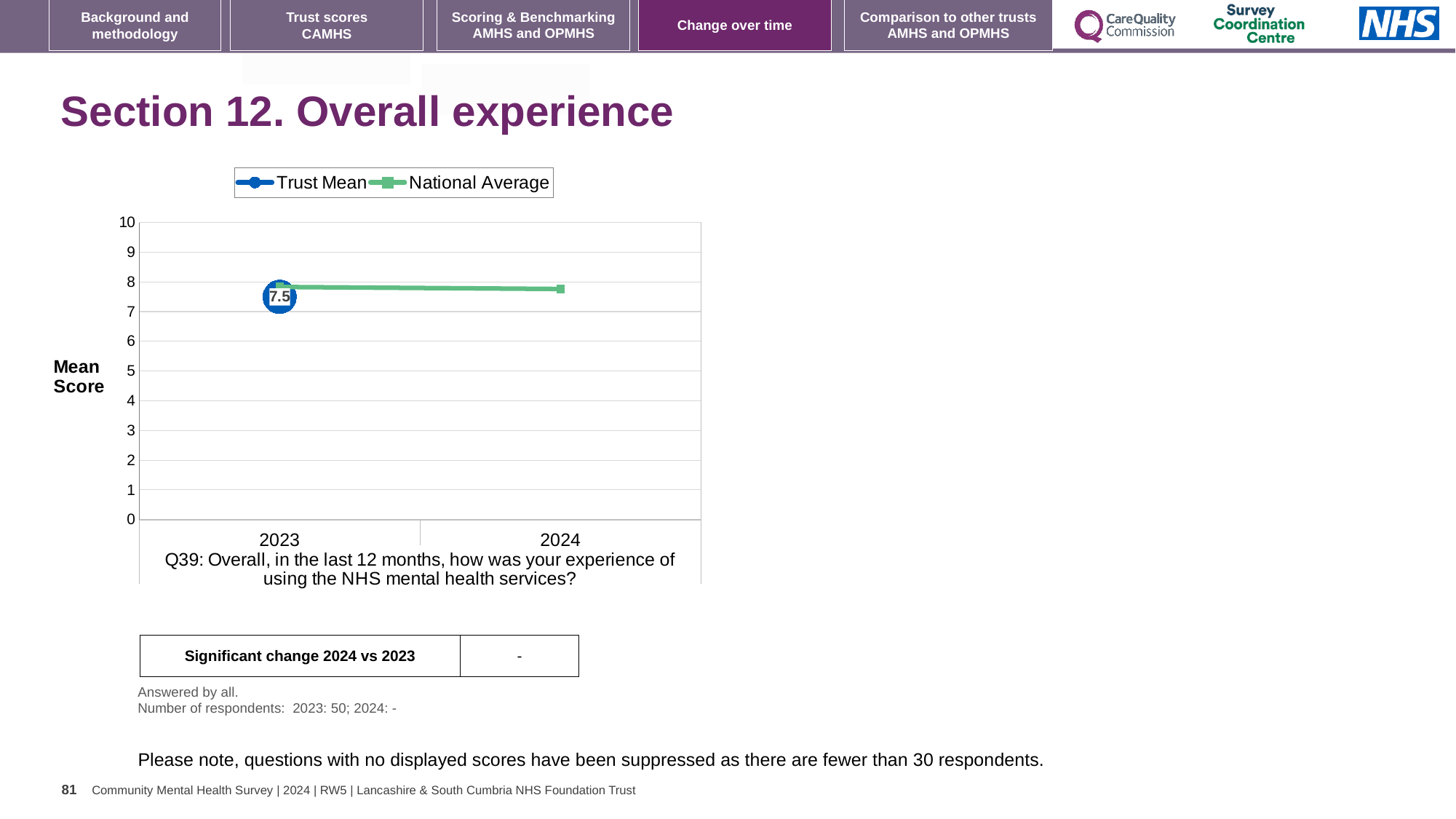
Which is higher in 2023, the Trust Mean or the National Average? National Average How many years are shown on the x axis of the chart? 2 Is the National Average value for 2023 greater or less than 5? greater Is the Trust Mean value for 2023 greater or less than 8? less What are the two series named in the chart legend? Trust Mean and National Average What kind of chart is shown on the slide? Line chart Is the National Average value for 2024 greater or less than 5? greater What is the label on the y axis of the chart? Mean Score What is the Trust Mean score for 2023? 7.5 How many series does the legend list? 2